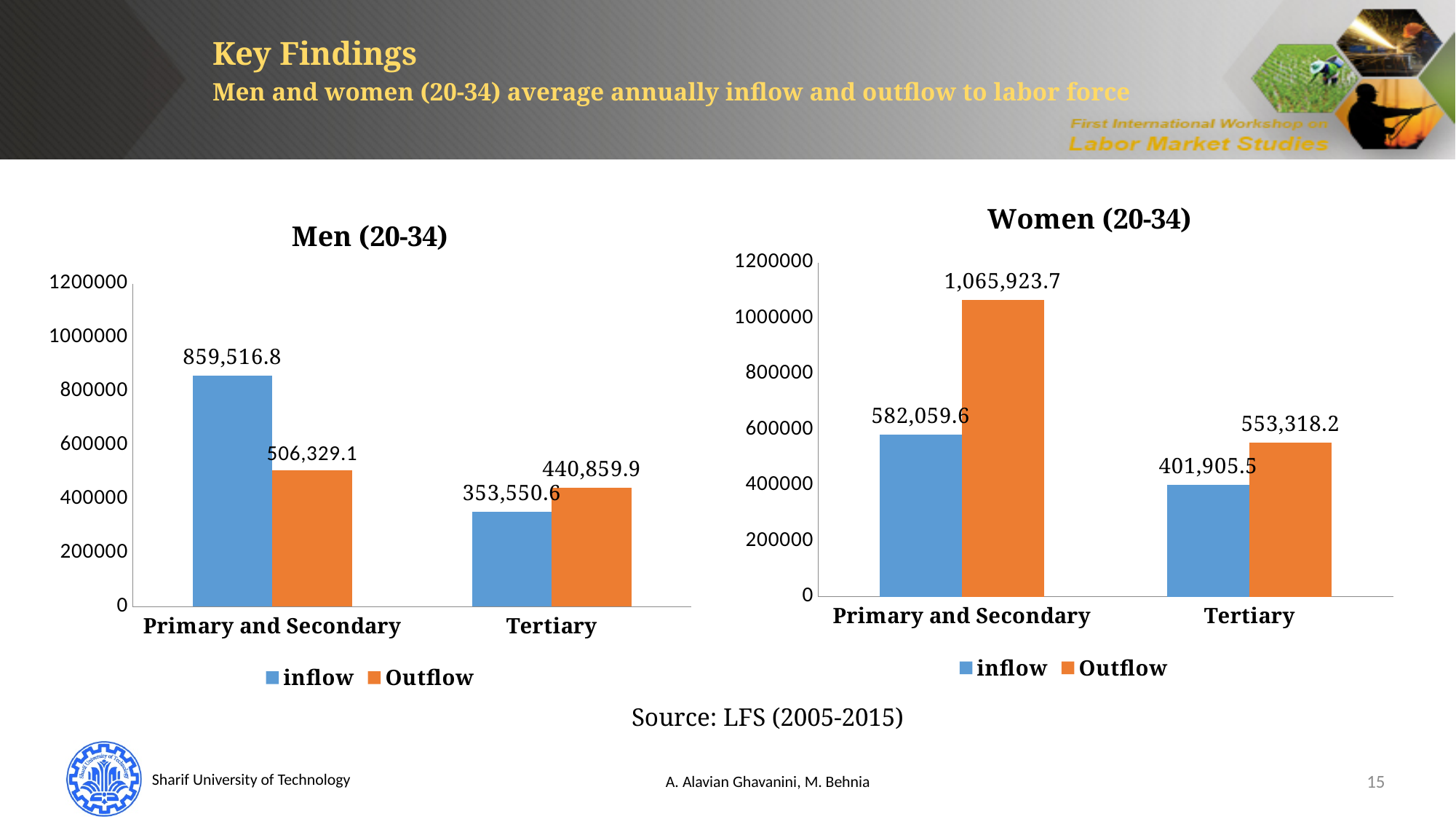
In the Men (20-34) chart, is inflow or Outflow larger for Tertiary? Outflow In the Men (20-34) chart, what is the Outflow value for Tertiary? 440,859.9 What kind of chart is the Women (20-34) chart? Bar chart In the Women (20-34) chart, what is the Outflow value for Primary and Secondary? 1,065,923.7 In the Women (20-34) chart, which bar is the highest? Outflow for Primary and Secondary In the Men (20-34) chart, which bar is the lowest? inflow for Tertiary In the Women (20-34) chart, what is the inflow value for Tertiary? 401,905.5 In the Men (20-34) chart, what is the difference between inflow and Outflow for Primary and Secondary? 353,187.7 In the Men (20-34) chart, what is the inflow value for Primary and Secondary? 859,516.8 How many series does the legend of the Men (20-34) chart list? 2 In the Women (20-34) chart, what is the difference between Outflow and inflow for Tertiary? 151,412.7 In the Women (20-34) chart, is the Outflow value for Primary and Secondary greater or less than 1000000? greater